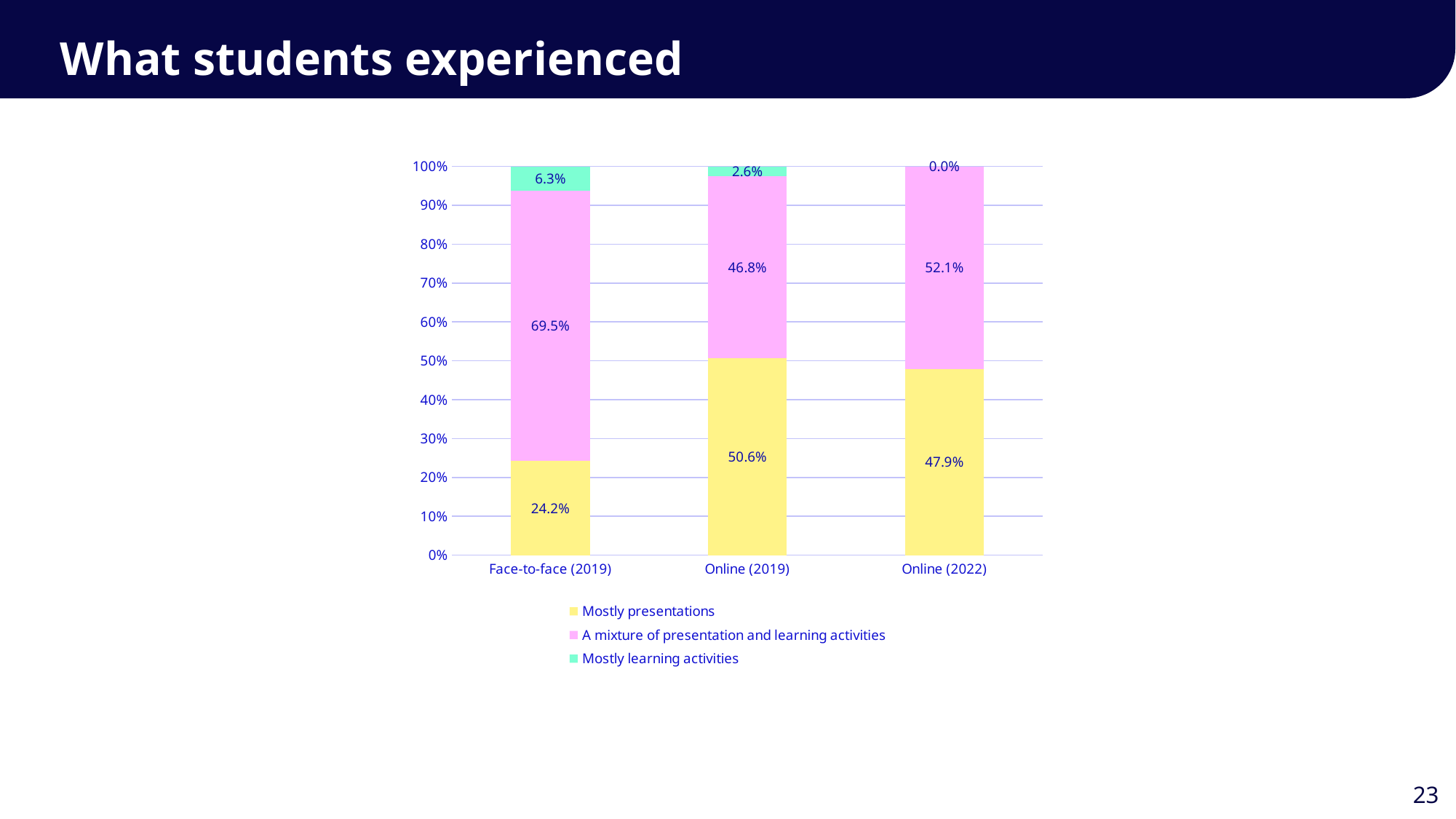
Which colour represents 'Mostly learning activities' in the legend? Green What percentage of Online (2022) students experienced a mixture of presentation and learning activities? 52.1% Which is larger: the 'Mostly presentations' share for Online (2019) or for Online (2022)? Online (2019) What percentage of Face-to-face (2019) students experienced mostly presentations? 24.2% Which category has the lowest share for 'Mostly learning activities'? Online (2022) What percentage of Online (2019) students experienced mostly learning activities? 2.6% What kind of chart is shown on the slide? Stacked bar chart How many series does the legend list? 3 What is the title of the slide? What students experienced How many categories are shown on the x axis? 3 What is the difference between the 'Mostly presentations' share for Online (2019) and Face-to-face (2019)? 26.4% Which category has the highest share for 'A mixture of presentation and learning activities'? Face-to-face (2019)